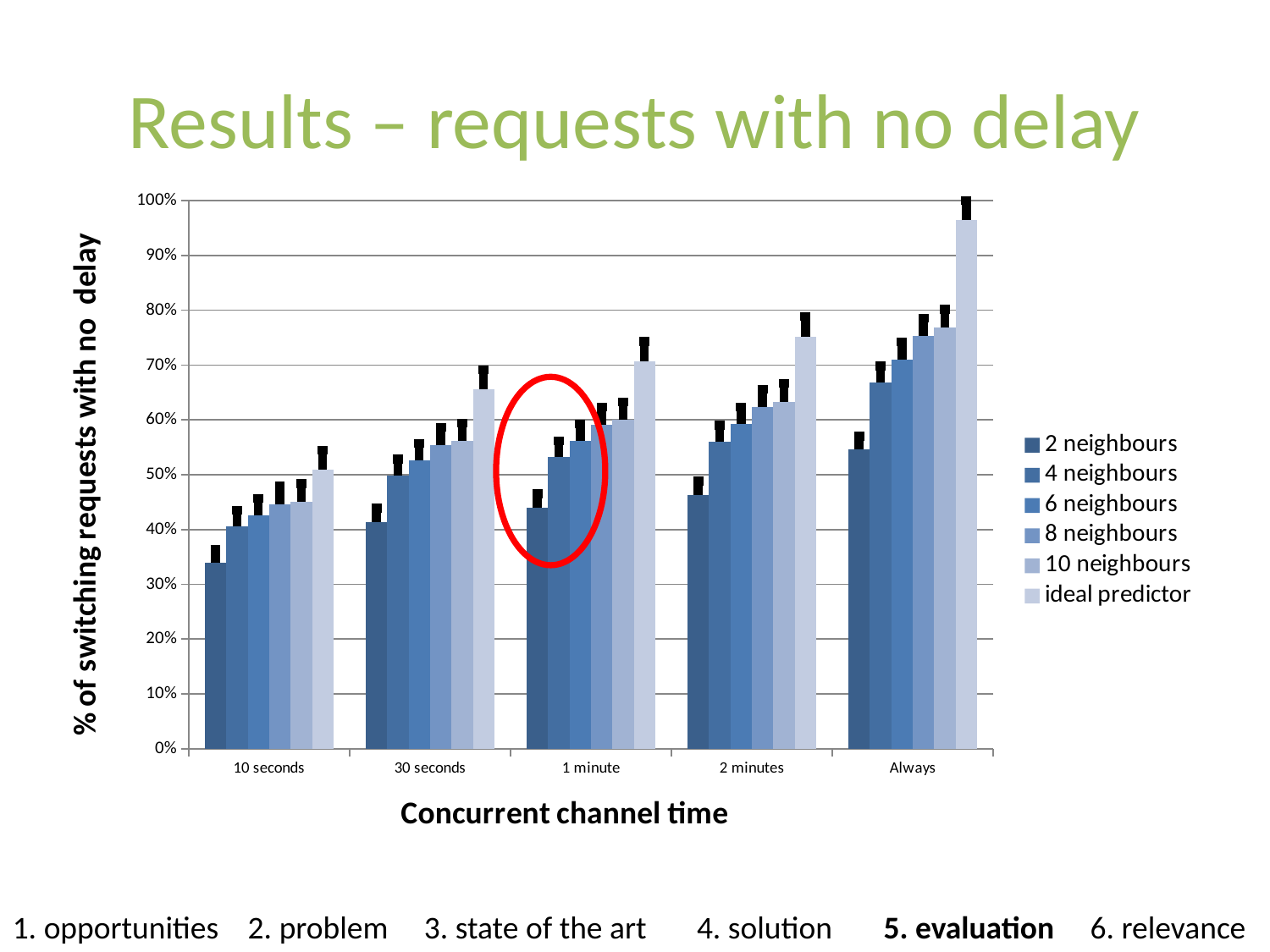
For which concurrent channel time is the ideal predictor value highest? Always For which concurrent channel time is the 2 neighbours value lowest? 10 seconds How many series does the legend list? 6 Is the 2 neighbours value for 10 seconds greater or less than 40%? less Do the 2 neighbours values rise or fall as concurrent channel time increases from 10 seconds to Always? rise What kind of chart is shown on the slide? bar chart Is the 2 neighbours value for Always greater or less than 50%? greater Is the ideal predictor value for 30 seconds greater or less than 60%? greater What is the title of the x axis? Concurrent channel time For 1 minute, which is larger: the ideal predictor value or the 2 neighbours value? ideal predictor How many concurrent channel time categories are shown on the x axis? 5